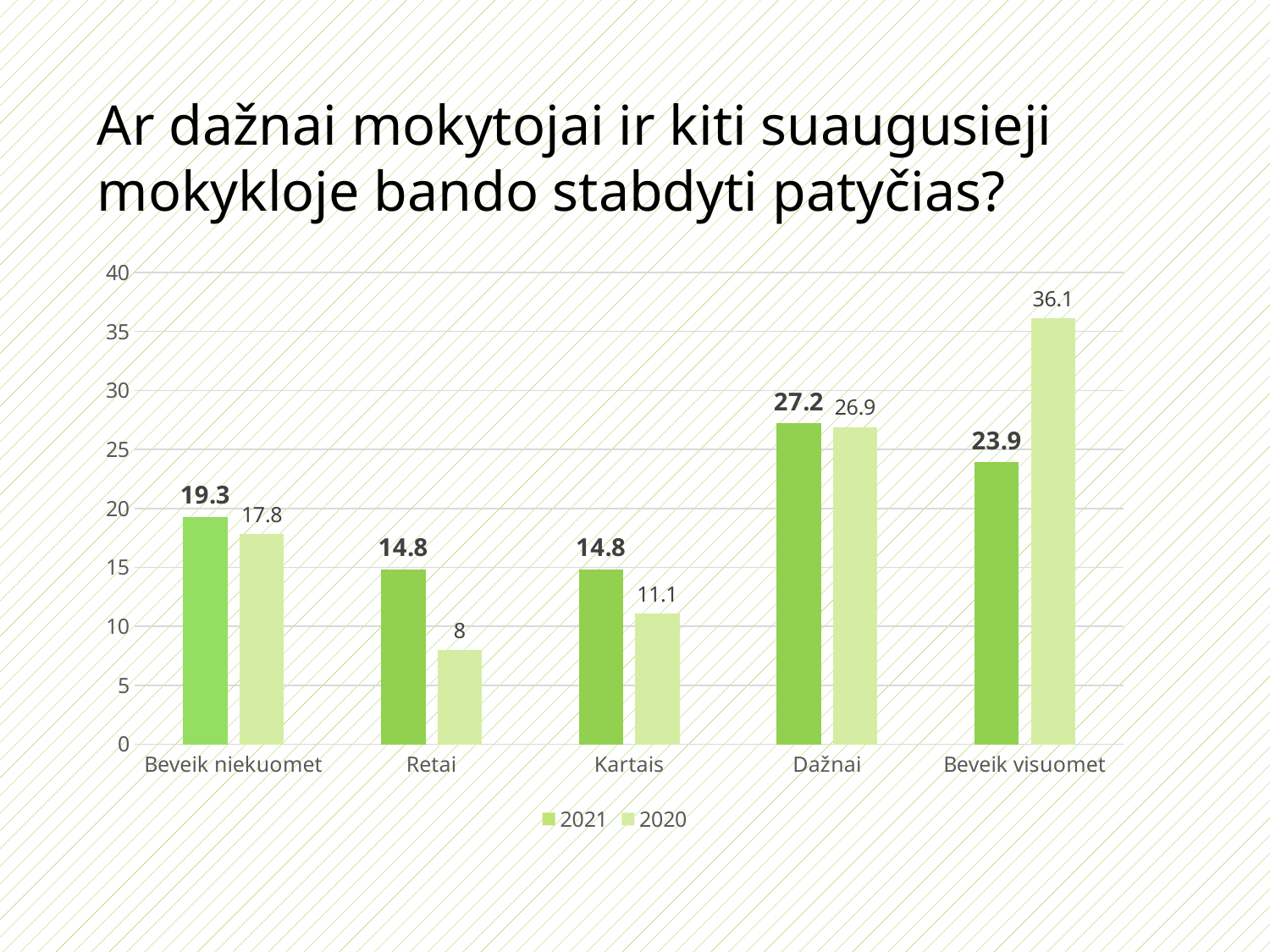
What is the 2020 value for Retai? 8 What is the 2020 value for Beveik visuomet? 36.1 How many series does the legend list? 2 How many categories are shown on the x axis? 5 Which is larger for Kartais, the 2021 value or the 2020 value? 2021 Which category has the lowest 2020 value? Retai Which category has the highest 2021 value? Dažnai What is the 2021 value for Dažnai? 27.2 What kind of chart is shown on the slide? Bar chart What is the difference between the 2020 and 2021 values for Beveik visuomet? 12.2 Which category has the highest 2020 value? Beveik visuomet What is the 2021 value for Beveik niekuomet? 19.3